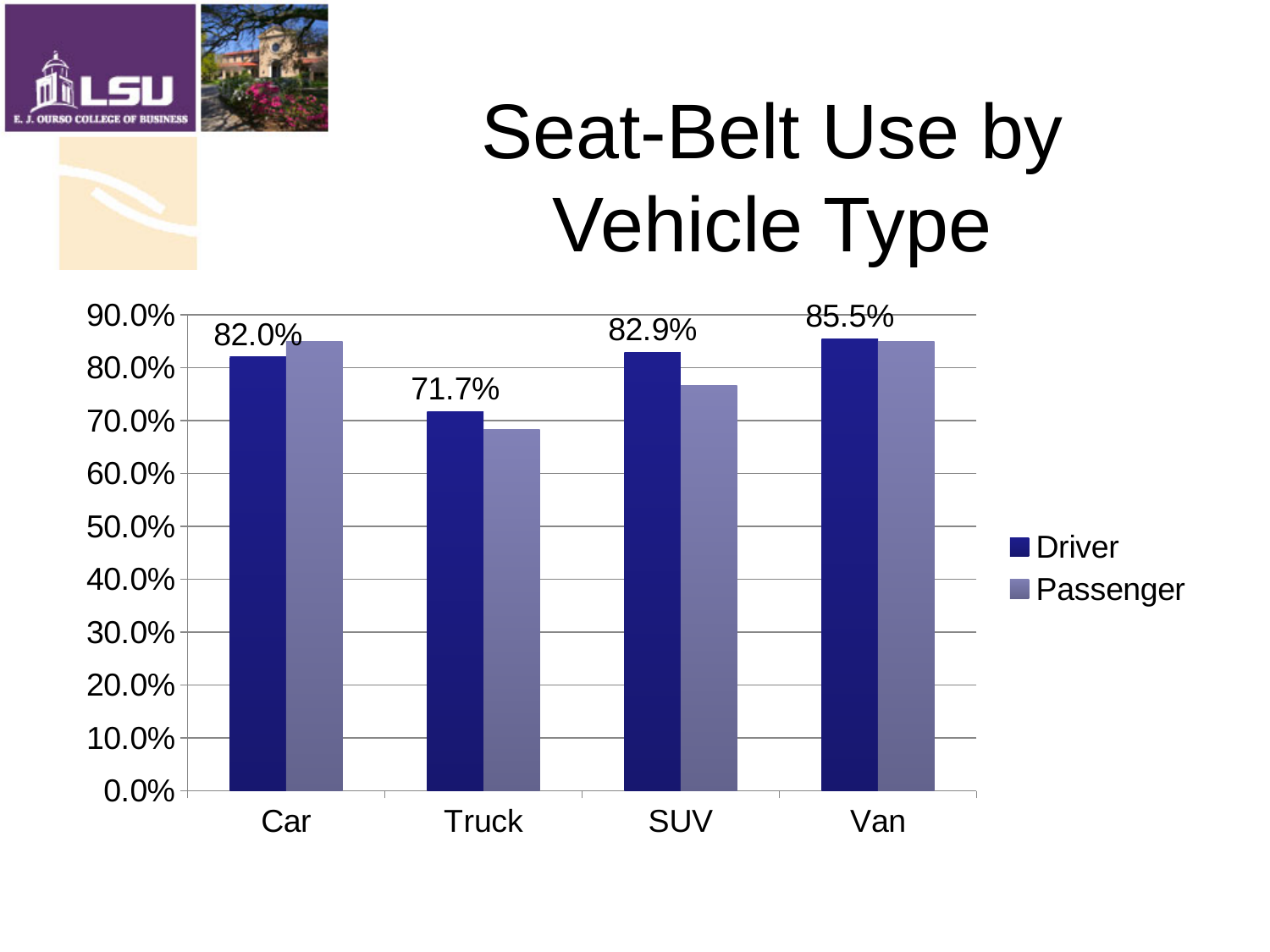
What is the Driver seat-belt use value for Truck? 71.7% Which vehicle type has the lowest Driver seat-belt use? Truck Is the Passenger value for Truck greater or less than 70.0%? less How many series does the legend list? 2 What is the Driver seat-belt use value for Van? 85.5% What is the Driver seat-belt use value for Car? 82.0% How many vehicle types are shown on the x axis? 4 What is the difference between the Driver values for Van and Truck? 13.8% Which is larger, the Driver value for SUV or the Driver value for Car? SUV Is the Passenger value for SUV greater or less than 70.0%? greater What kind of chart is shown on the slide? Bar chart Which vehicle type has the highest Driver seat-belt use? Van